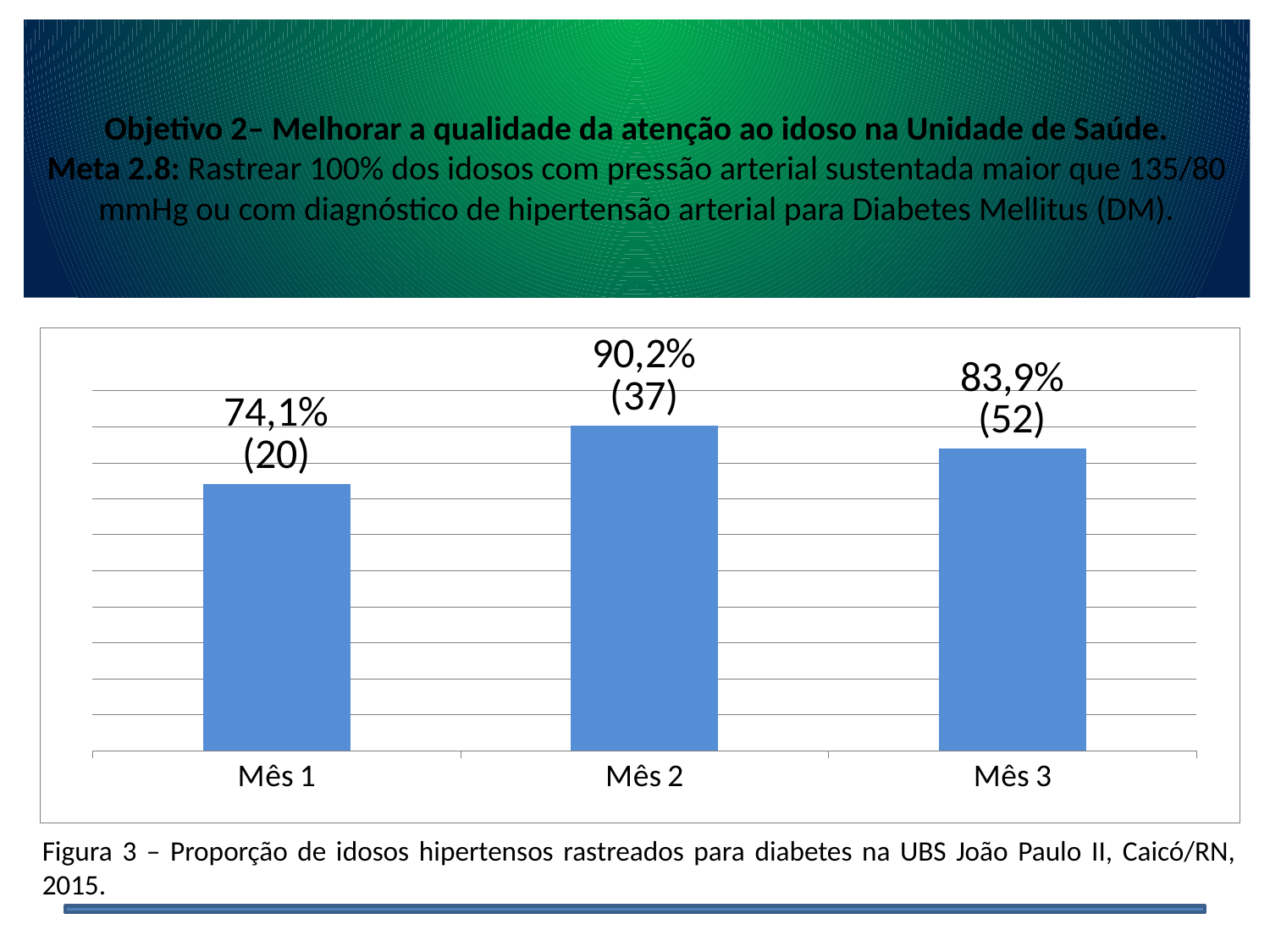
What count is shown in parentheses for Mês 3? 52 Which month has the lowest percentage? Mês 1 What is the difference in percentage points between Mês 2 and Mês 1? 16,1 What is the figure number given in the caption below the chart? Figura 3 What type of chart is shown? Bar chart How many months are shown on the chart? 3 What percentage is shown for Mês 2? 90,2% What count is shown in parentheses for Mês 1? 20 What percentage is shown for Mês 1? 74,1% Which month has the highest percentage? Mês 2 Which has a higher percentage, Mês 2 or Mês 3? Mês 2 What percentage is shown for Mês 3? 83,9%